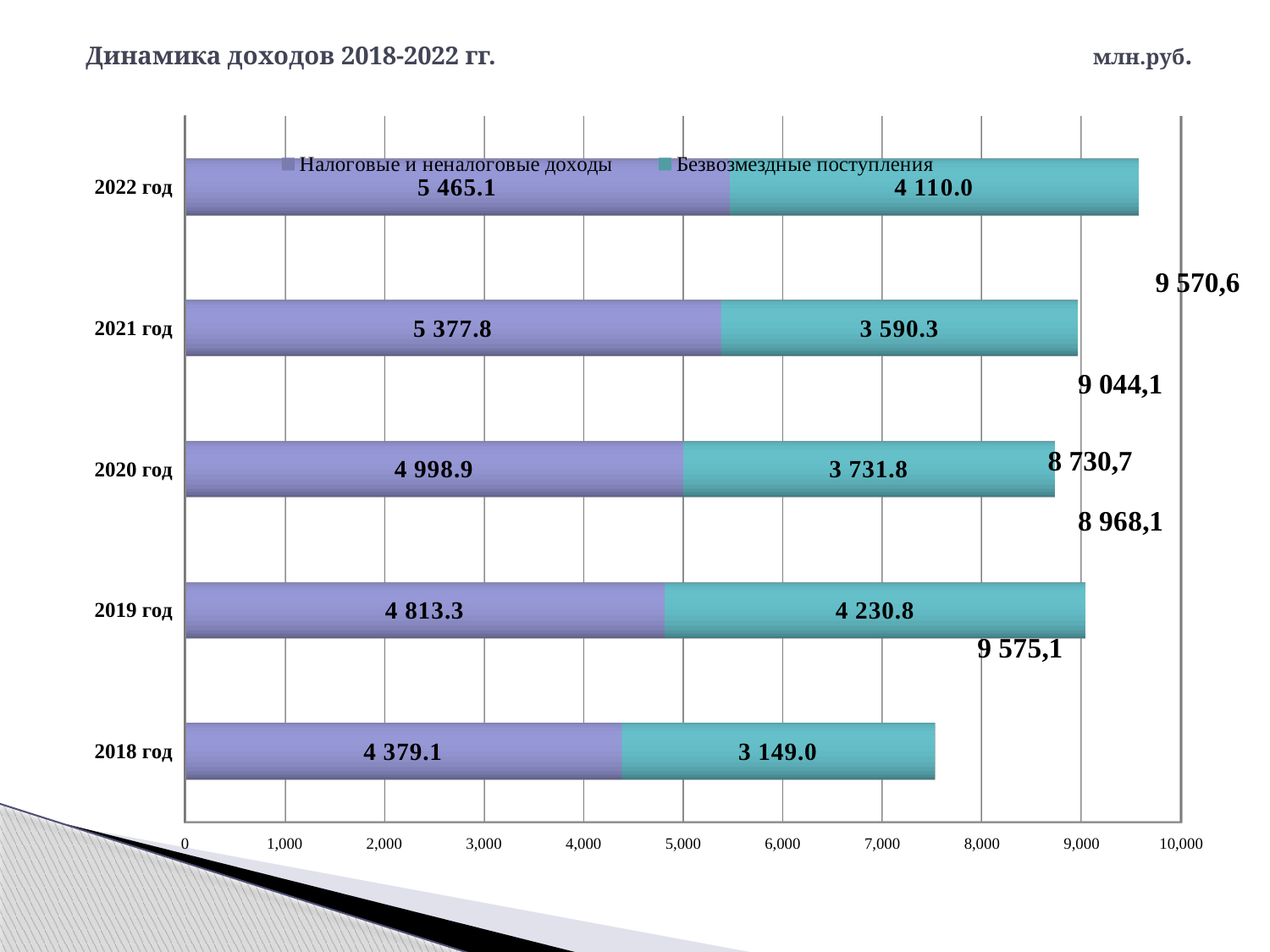
Which year has the lowest value of Безвозмездные поступления? 2018 год How many series does the legend list? 2 How many years (categories) are plotted on the chart? 5 What is the difference between Налоговые и неналоговые доходы in 2021 год and 2020 год? 378.9 Do the values of Налоговые и неналоговые доходы rise or fall from 2018 год to 2022 год? Rise What is the total of the stacked bar for 2018 год? 7 528.1 Which year has the highest value of Налоговые и неналоговые доходы? 2022 год Which is larger: Безвозмездные поступления in 2020 год or in 2021 год? 2020 год What is the value of Налоговые и неналоговые доходы for 2022 год? 5 465.1 What is the value of Безвозмездные поступления for 2018 год? 3 149.0 What is the value of Безвозмездные поступления for 2019 год? 4 230.8 What kind of chart is shown on the slide? Stacked bar chart